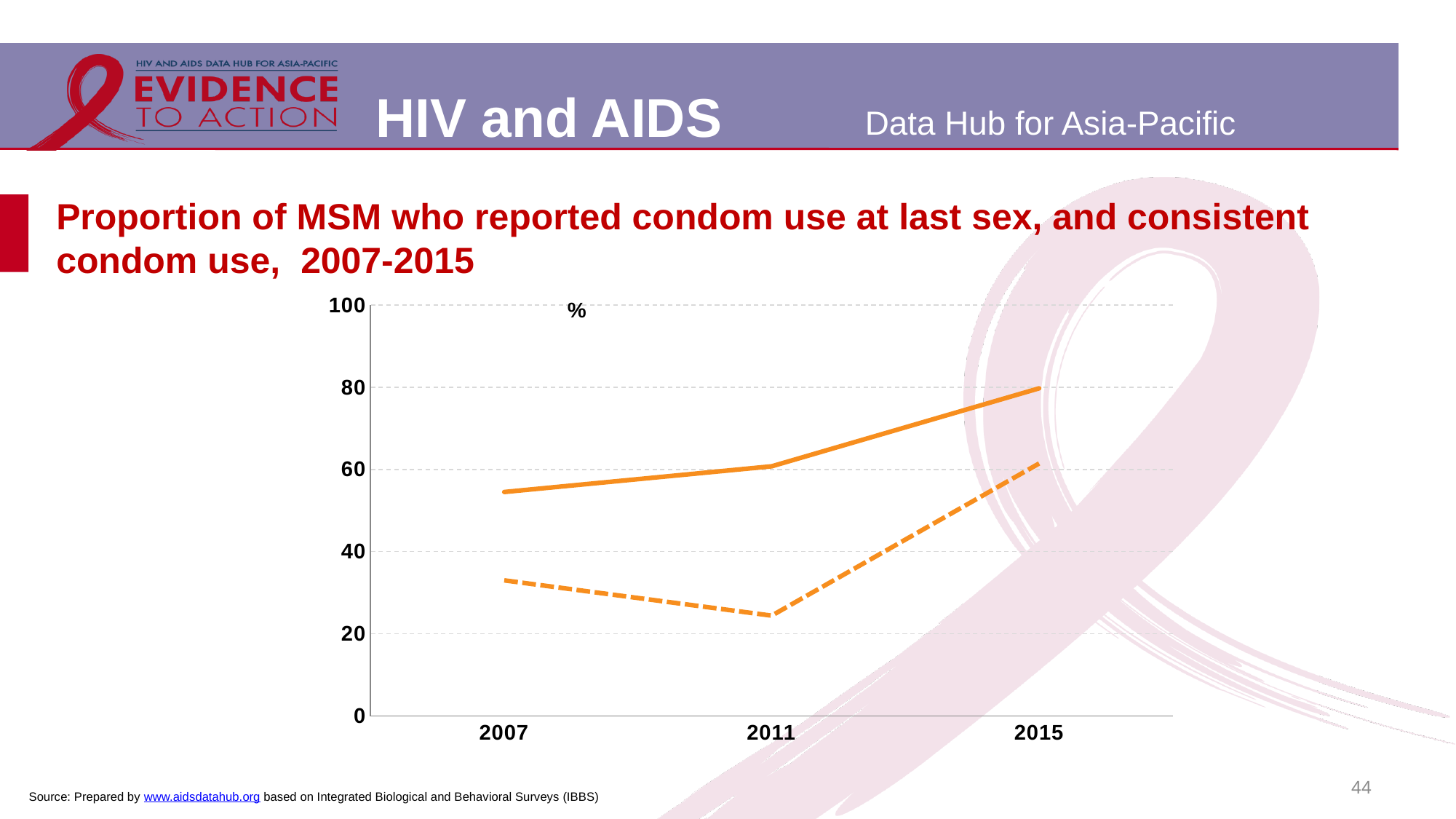
How many years are marked on the x axis of the chart? 3 What unit is shown at the top of the y axis? % Is the value of the solid line in 2007 greater or less than 40? greater What kind of chart is shown on the slide? line chart In which year does the dashed line reach its lowest value? 2011 Is the value of the dashed line in 2015 greater or less than 40? greater Is the value of the dashed line in 2011 greater or less than 40? less How many lines are plotted on the chart? 2 Does the dashed line rise or fall between 2007 and 2011? fall Does the solid line rise or fall from 2007 to 2015? rise In 2007, which line has the higher value, the solid line or the dashed line? solid line